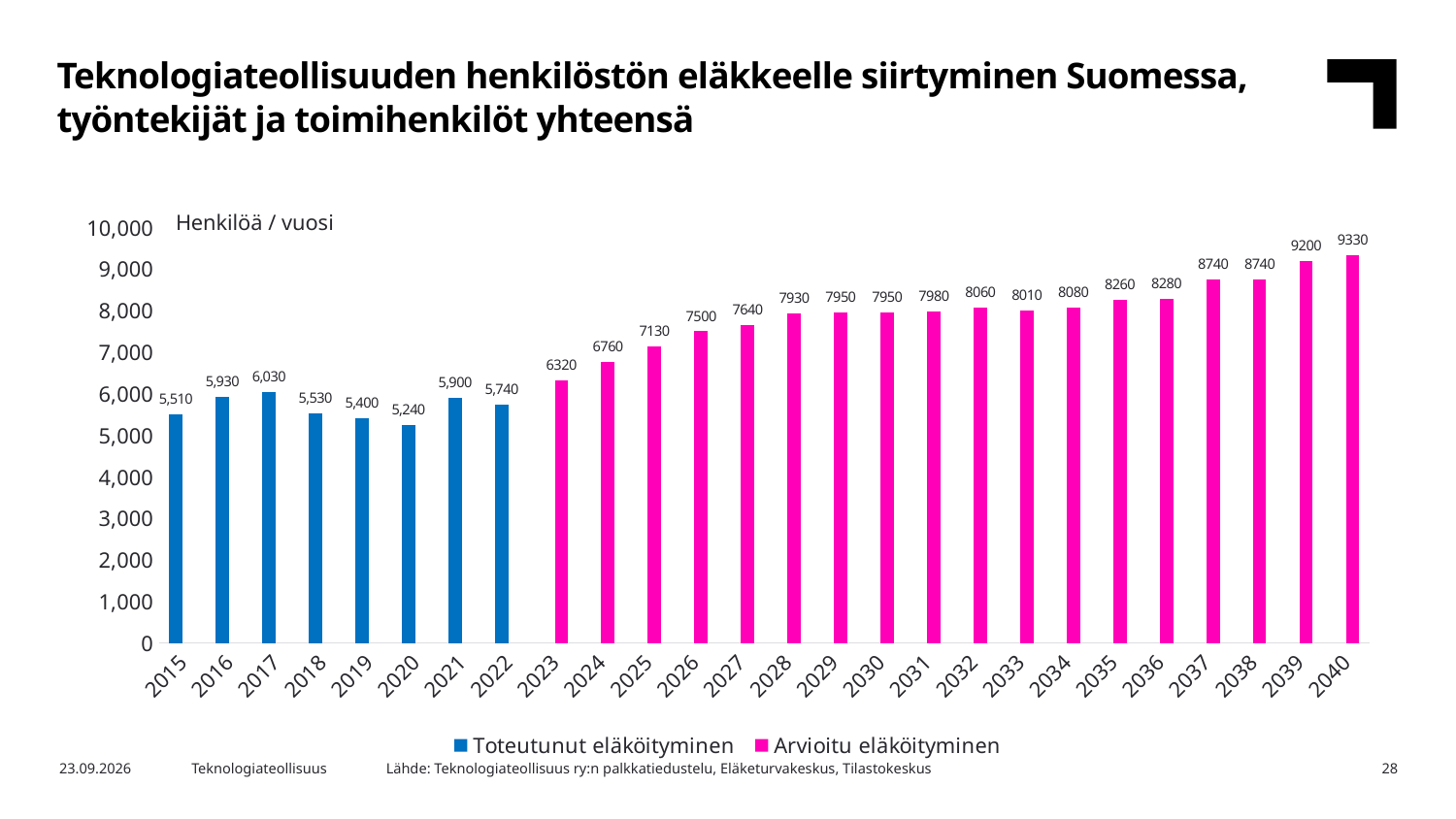
What is the difference between the values for 2040 and 2039? 130 How many years are shown on the x axis? 26 What is the value for 2030? 7950 What kind of chart is shown on the slide? bar chart Which is larger, the value for 2021 or the value for 2022? 2021 What is the difference between the values for 2016 and 2015? 420 What is the value for 2040? 9330 What is the value for 2017? 6,030 How many series does the legend list? 2 Which year has the highest value? 2040 Which year has the lowest value? 2020 Is the value for 2035 greater or less than 8,000? greater